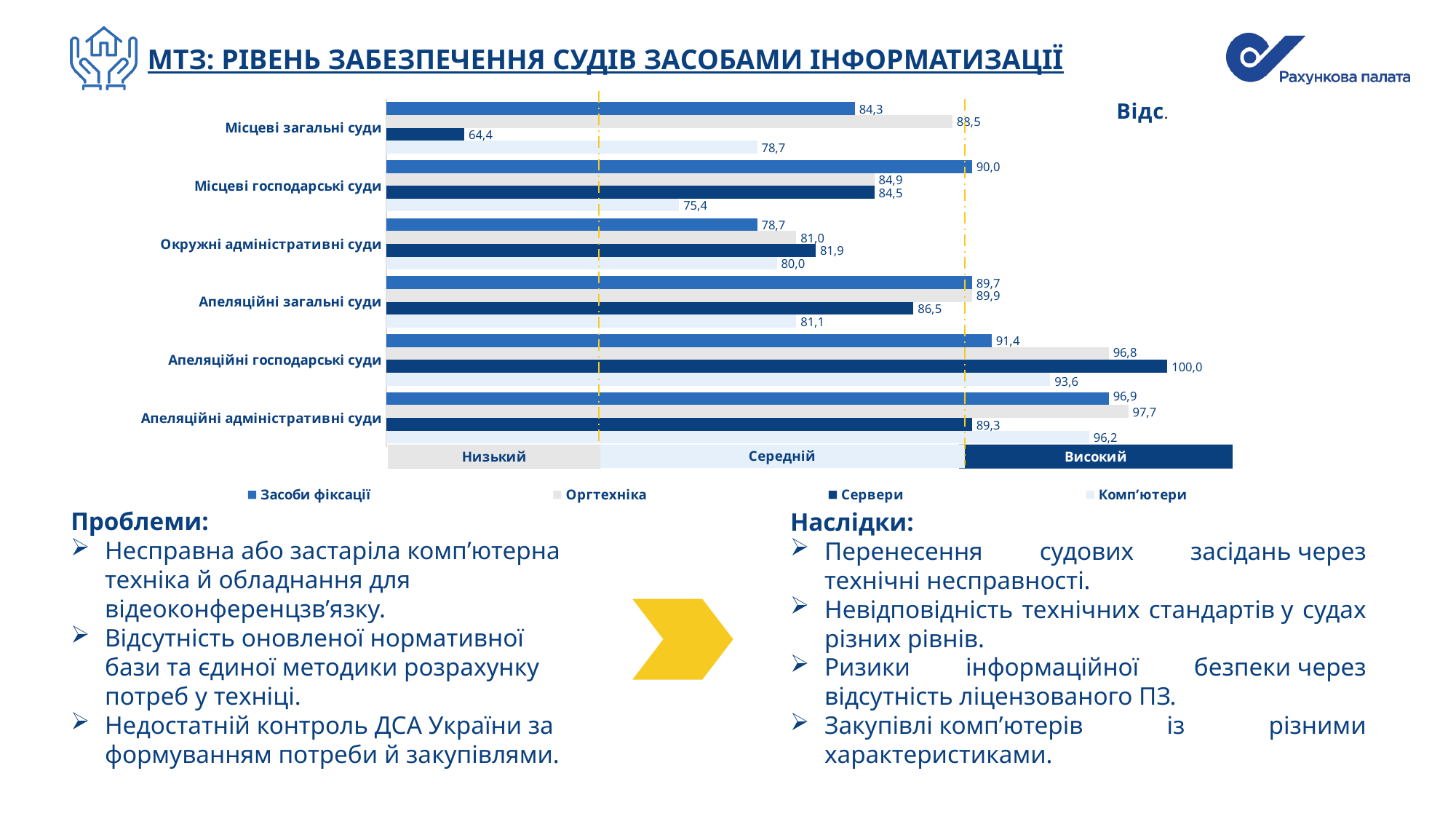
What is the value of Засоби фіксації for Місцеві господарські суди? 90,0 How many court categories are shown on the chart? 6 How many series does the legend list? 4 What is the value of Оргтехніка for Апеляційні адміністративні суди? 97,7 Which series is shown in the lightest colour in the legend? Комп’ютери Which court category has the lowest value for Комп’ютери? Місцеві господарські суди What is the difference between the Сервери values for Апеляційні господарські суди and Місцеві загальні суди? 35,6 What type of chart is shown on the slide? Bar chart Which court category has the highest value for Сервери? Апеляційні господарські суди What is the value of Комп’ютери for Апеляційні господарські суди? 93,6 Which is larger for Окружні адміністративні суди: Засоби фіксації or Сервери? Сервери What is the value of Сервери for Місцеві загальні суди? 64,4